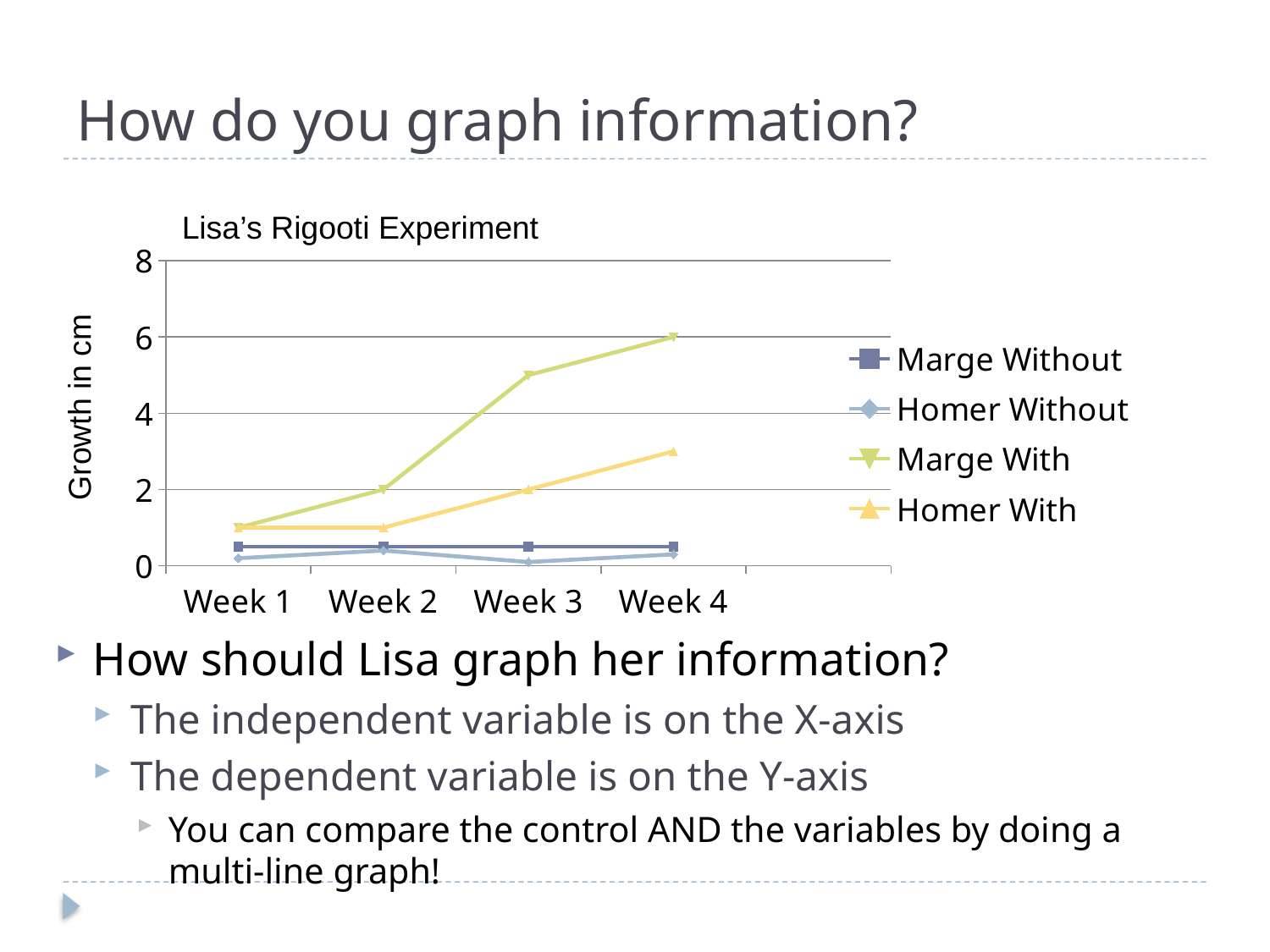
How many weeks are shown on the x-axis? 4 What is the label on the y-axis of the chart? Growth in cm How many series does the legend list? 4 Which series has the lowest value at Week 3? Homer Without Does the Marge With series rise or fall from Week 1 to Week 4? Rise What is the value for Marge With at Week 2? 2 What is the value for Homer With at Week 3? 2 Is the value for Marge With at Week 3 greater or less than 4? greater What type of chart is shown on the slide? Line chart Which series has the highest value at Week 4? Marge With What is the value for Marge With at Week 4? 6 What is the title of the chart? Lisa's Rigooti Experiment